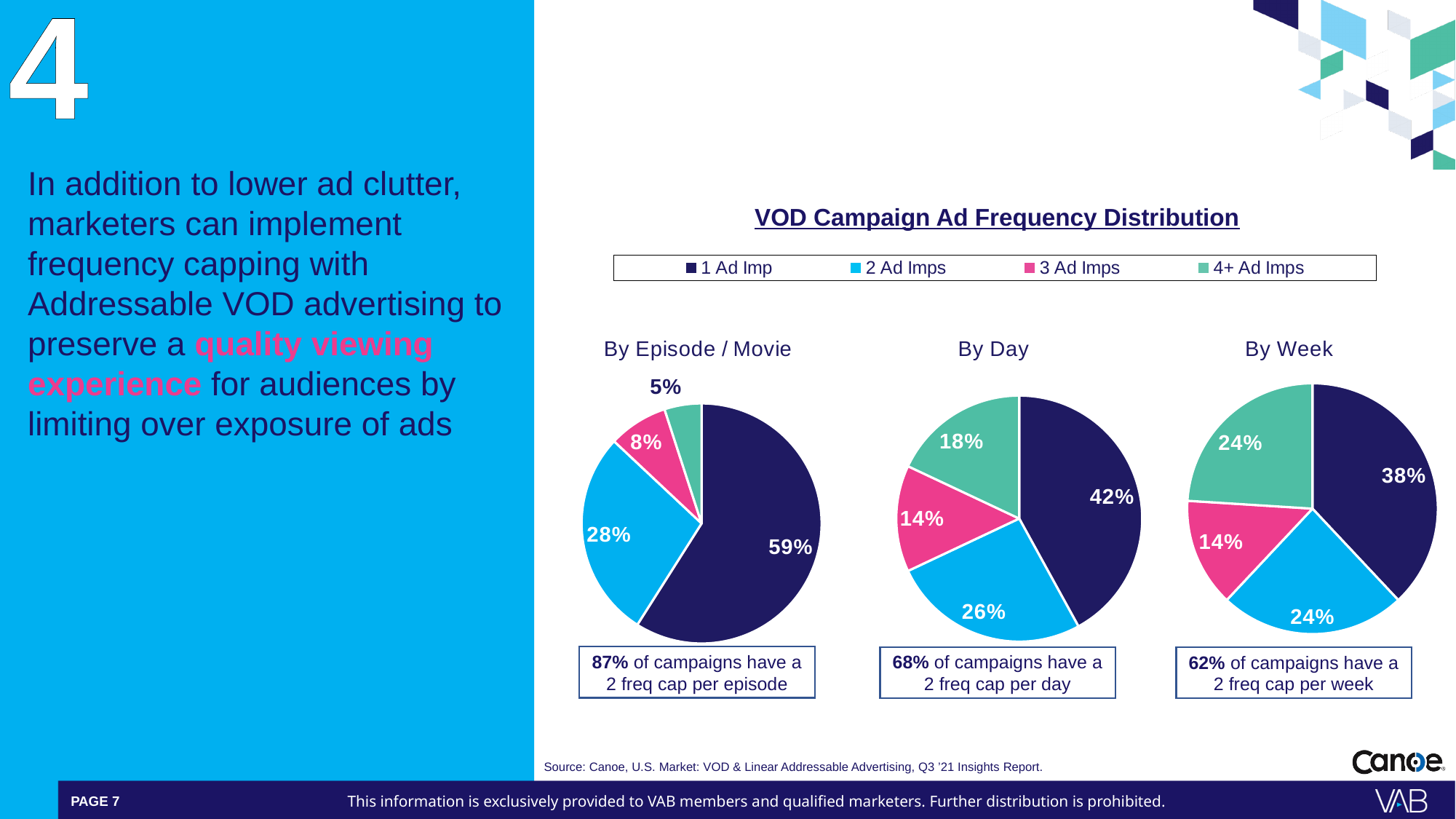
In the 'By Day' pie chart, what share is shown for 2 Ad Imps? 26% How many slices does the 'By Day' pie chart have? 4 In the 'By Episode / Movie' pie chart, which category has the smallest slice? 4+ Ad Imps In the 'By Day' pie chart, which is larger: the 3 Ad Imps slice or the 4+ Ad Imps slice? 4+ Ad Imps In the 'By Episode / Movie' pie chart, what is the combined share of 1 Ad Imp and 2 Ad Imps? 87% In the 'By Episode / Movie' pie chart, what share of campaigns had 1 Ad Imp? 59% In the 'By Week' pie chart, what is the difference between the 1 Ad Imp slice and the 3 Ad Imps slice? 24% What kind of chart is used for the 'By Week' breakdown? Pie chart In the 'By Day' pie chart, which category has the largest slice? 1 Ad Imp In the 'By Week' pie chart, what share is shown for 4+ Ad Imps? 24% How many series does the legend of the VOD Campaign Ad Frequency Distribution chart list? 4 What is the title of the chart group on the slide? VOD Campaign Ad Frequency Distribution